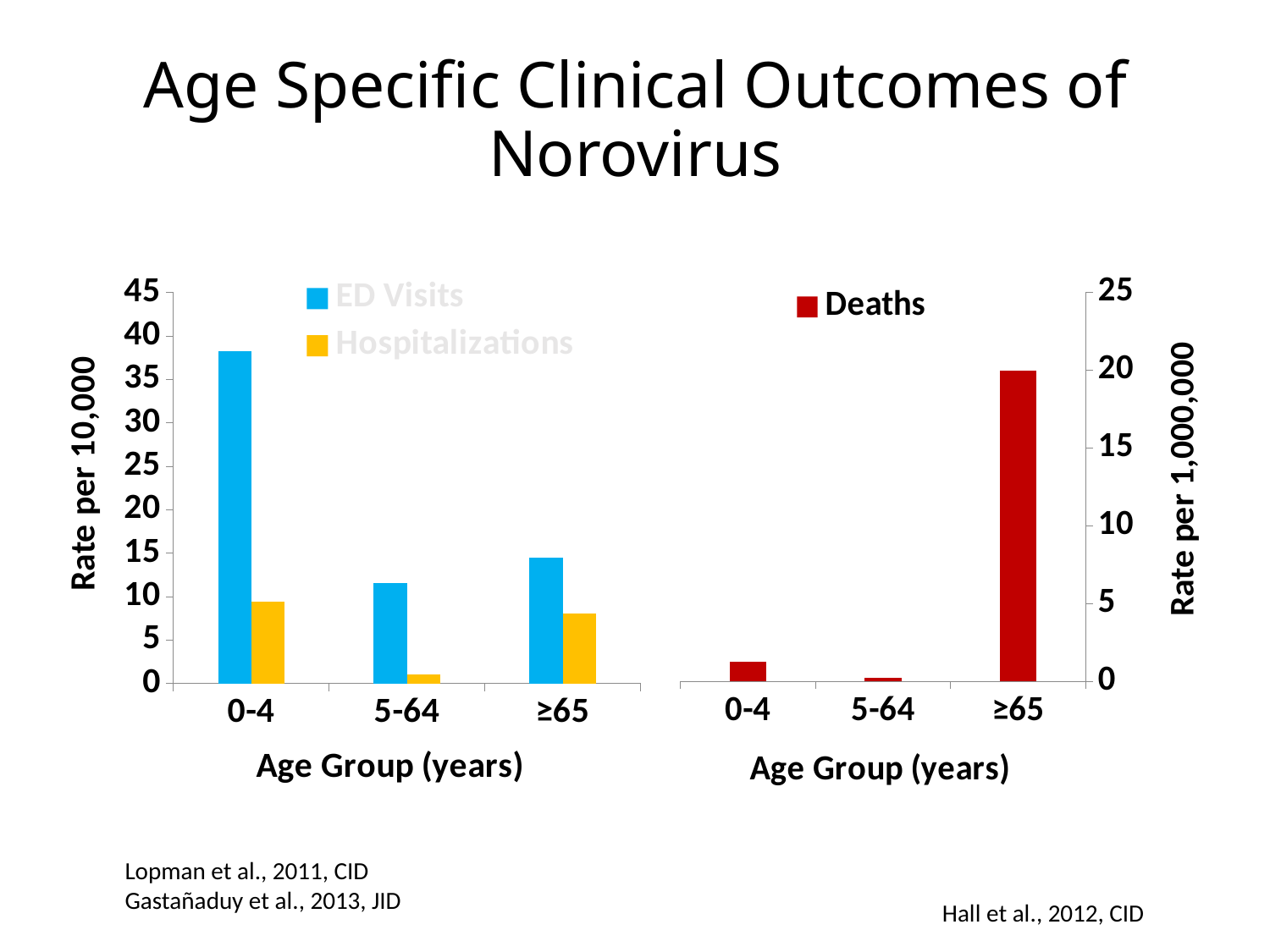
In the left chart, which is larger for the 0-4 age group, ED Visits or Hospitalizations? ED Visits In the right chart, which age group has the highest rate of Deaths? ≥65 In the left chart, is the ED Visits value for the 5-64 age group greater or less than 10? greater In the right chart, is the Deaths value for the ≥65 age group greater or less than 15? greater In the left chart, is the ED Visits value for the 0-4 age group greater or less than 35? greater In the left chart, which age group has the lowest rate of Hospitalizations? 5-64 How many age groups are shown on the x axis of the right chart? 3 How many series does the legend of the left chart list? 2 What is the y-axis title of the right chart (Deaths)? Rate per 1,000,000 In the left chart, which age group has the highest rate of ED Visits? 0-4